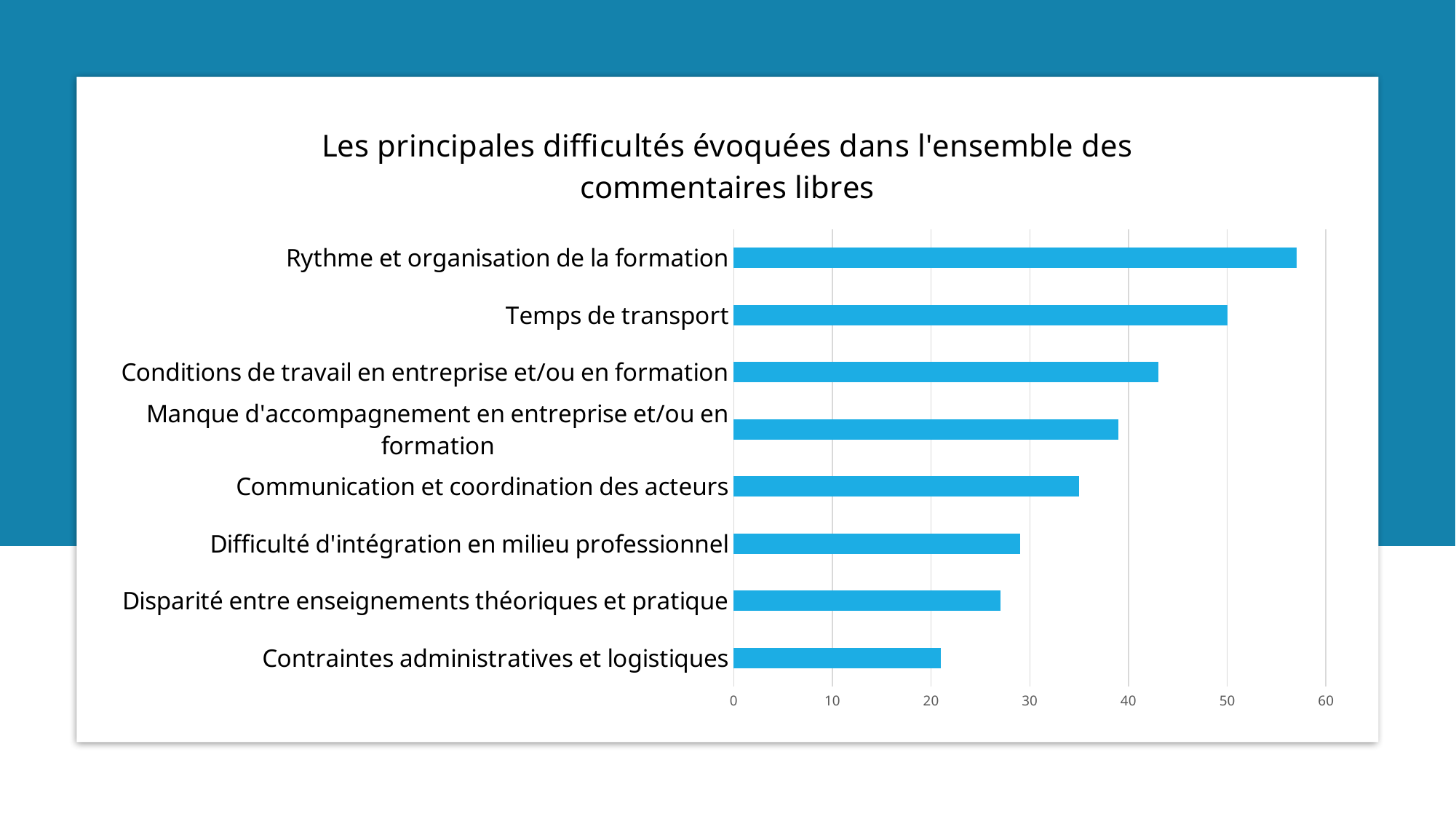
Is the value for Contraintes administratives et logistiques greater or less than 30? less Which is larger: the value for Temps de transport or the value for Difficulté d'intégration en milieu professionnel? Temps de transport Is the value for Conditions de travail en entreprise et/ou en formation greater or less than 40? greater What is the title of the chart? Les principales difficultés évoquées dans l'ensemble des commentaires libres Is the value for Communication et coordination des acteurs greater or less than 40? less Which difficulty has the highest value in the chart? Rythme et organisation de la formation How many categories (difficulties) are plotted in the chart? 8 What is the value for Temps de transport? 50 What kind of chart is shown on the slide? bar chart Which difficulty has the lowest value in the chart? Contraintes administratives et logistiques